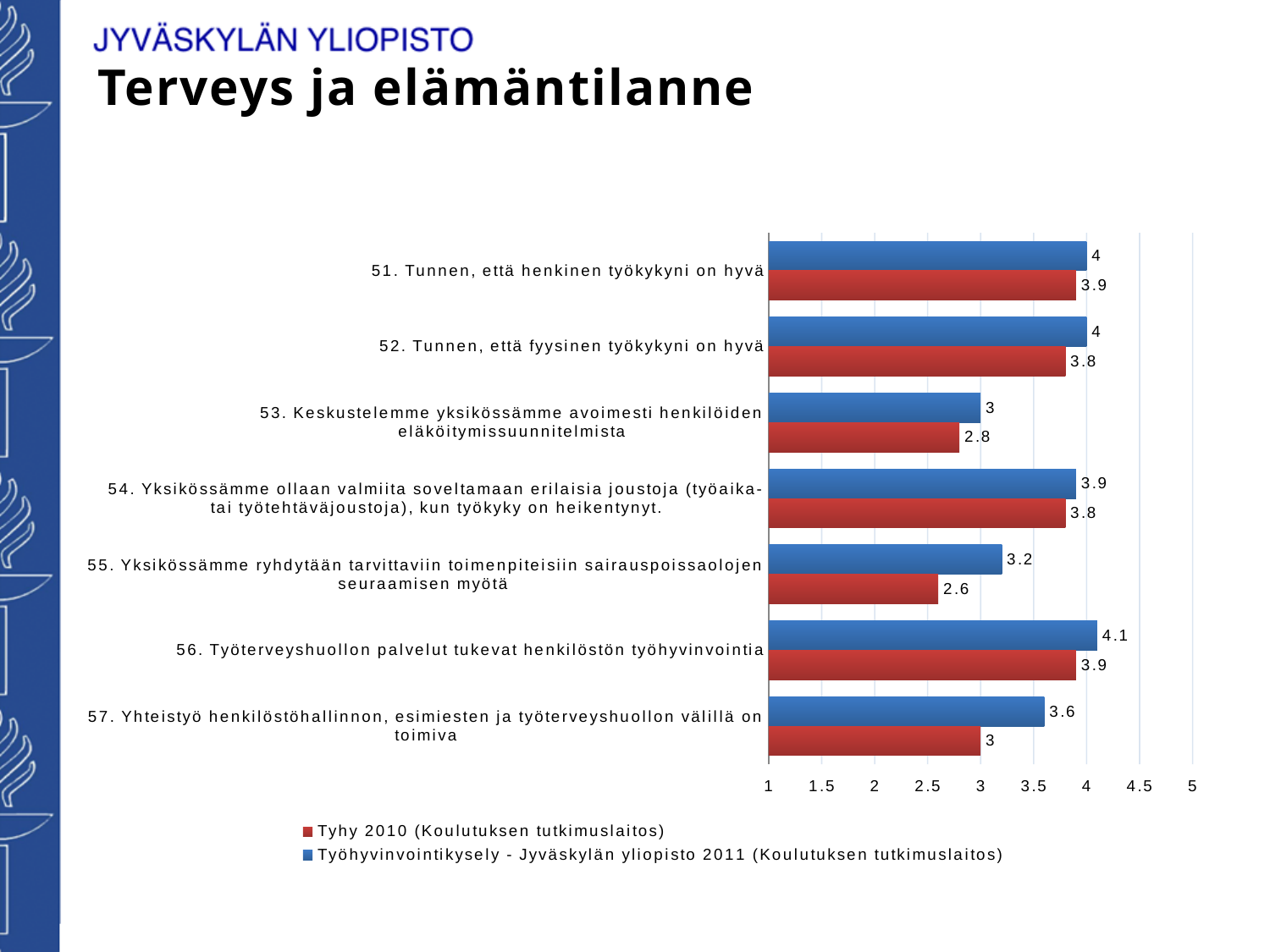
Which item has the lowest value in the Työhyvinvointikysely 2011 series? 53. Keskustelemme yksikössämme avoimesti henkilöiden eläköitymissuunnitelmista Which item has the highest value in the Työhyvinvointikysely 2011 series? 56. Työterveyshuollon palvelut tukevat henkilöstön työhyvinvointia What is the value for item 55 (Yksikössämme ryhdytään tarvittaviin toimenpiteisiin sairauspoissaolojen seuraamisen myötä) in the Tyhy 2010 series? 2.6 What is the difference between the 2011 and 2010 values for item 55? 0.6 How many items (categories) are shown in the chart? 7 How many series does the legend list? 2 What type of chart is shown on the slide? Bar chart Which item has the lowest value in the Tyhy 2010 series? 55. Yksikössämme ryhdytään tarvittaviin toimenpiteisiin sairauspoissaolojen seuraamisen myötä For item 52, which series has the larger value, Tyhy 2010 or Työhyvinvointikysely 2011? Työhyvinvointikysely 2011 What is the value for item 53 (Keskustelemme yksikössämme avoimesti henkilöiden eläköitymissuunnitelmista) in the Tyhy 2010 series? 2.8 What is the value for item 56 (Työterveyshuollon palvelut tukevat henkilöstön työhyvinvointia) in the Työhyvinvointikysely 2011 series? 4.1 What is the difference between the 2011 and 2010 values for item 57? 0.6